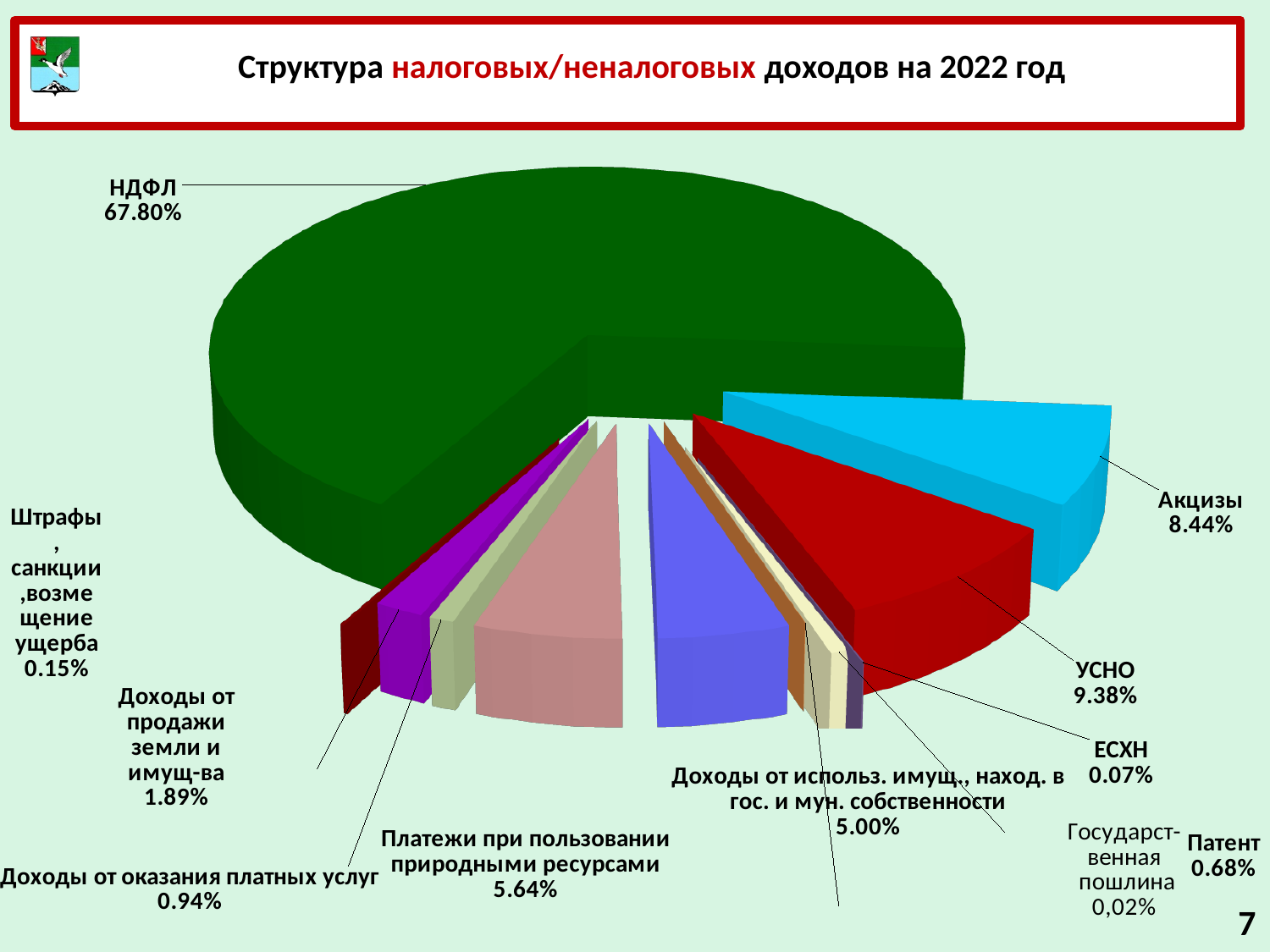
Which has a larger share: Доходы от продажи земли и имущ-ва or Доходы от оказания платных услуг? Доходы от продажи земли и имущ-ва Which category has the smallest share in the pie chart? Государственная пошлина What is the share of Акцизы in the pie chart? 8.44% What is the share of НДФЛ in the pie chart? 67.80% How many categories are shown in the pie chart? 11 What is the share of Платежи при пользовании природными ресурсами in the pie chart? 5.64% What is the share of Патент in the pie chart? 0.68% What kind of chart is shown on the slide? Pie chart What is the share of УСНО in the pie chart? 9.38% Which category has the largest share in the pie chart? НДФЛ What is the title of the slide? Структура налоговых/неналоговых доходов на 2022 год What is the difference between the shares of УСНО and Акцизы? 0.94%